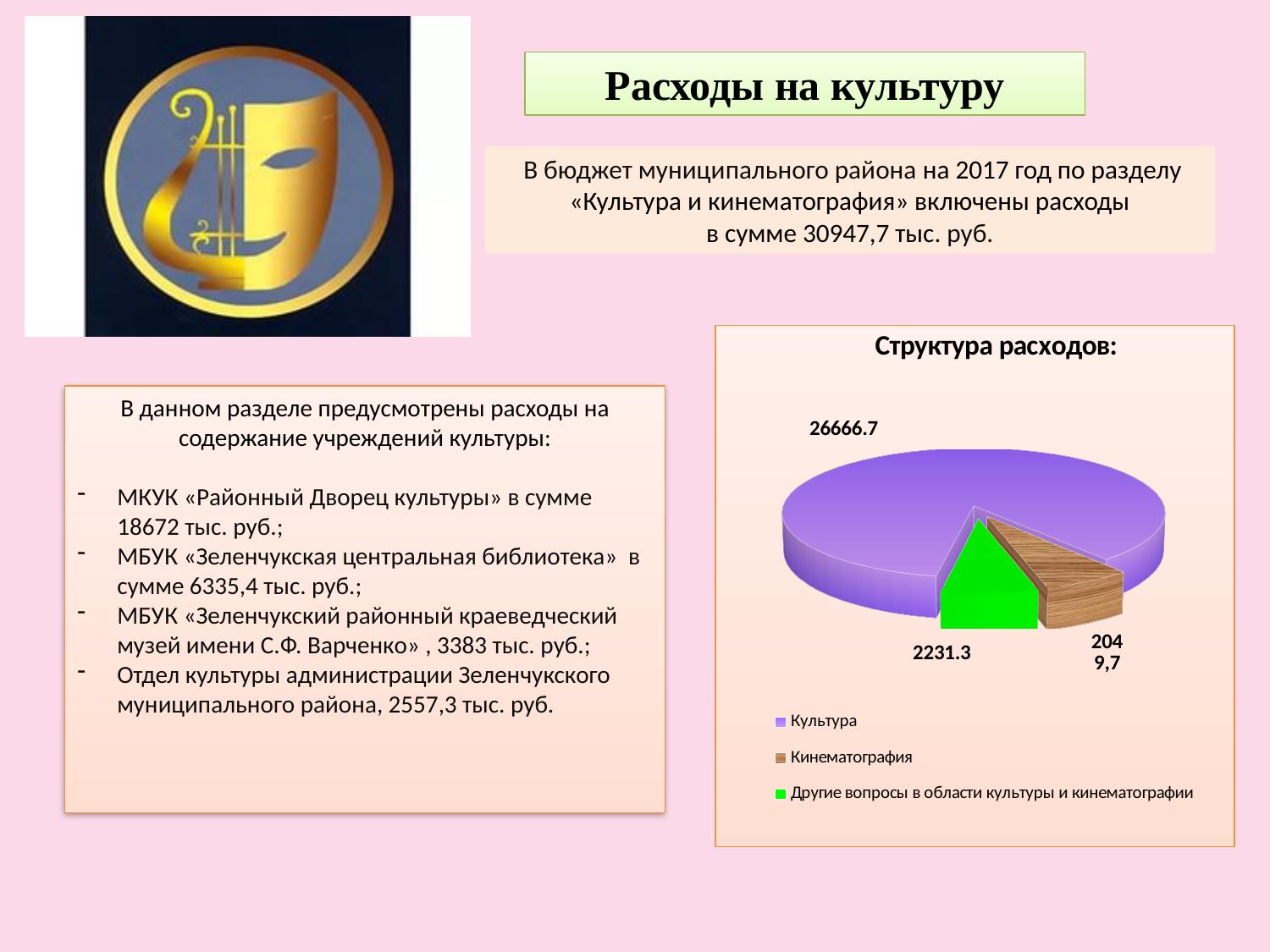
In the pie chart "Структура расходов:", what is the value for Культура? 26666.7 In the pie chart "Структура расходов:", what is the difference between the value for Культура and the value for Другие вопросы в области культуры и кинематографии? 24435.4 In the pie chart "Структура расходов:", what is the value for Другие вопросы в области культуры и кинематографии? 2231.3 What kind of chart is shown under the title "Структура расходов:"? pie chart Which category has the largest slice in the pie chart "Структура расходов:"? Культура How many entries does the legend of the pie chart "Структура расходов:" list? 3 What colour is the Культура slice in the pie chart "Структура расходов:"? purple In the pie chart "Структура расходов:", which is larger: Культура or Другие вопросы в области культуры и кинематографии? Культура How many slices does the pie chart "Структура расходов:" have? 3 What is the title of the pie chart on the slide? Структура расходов: